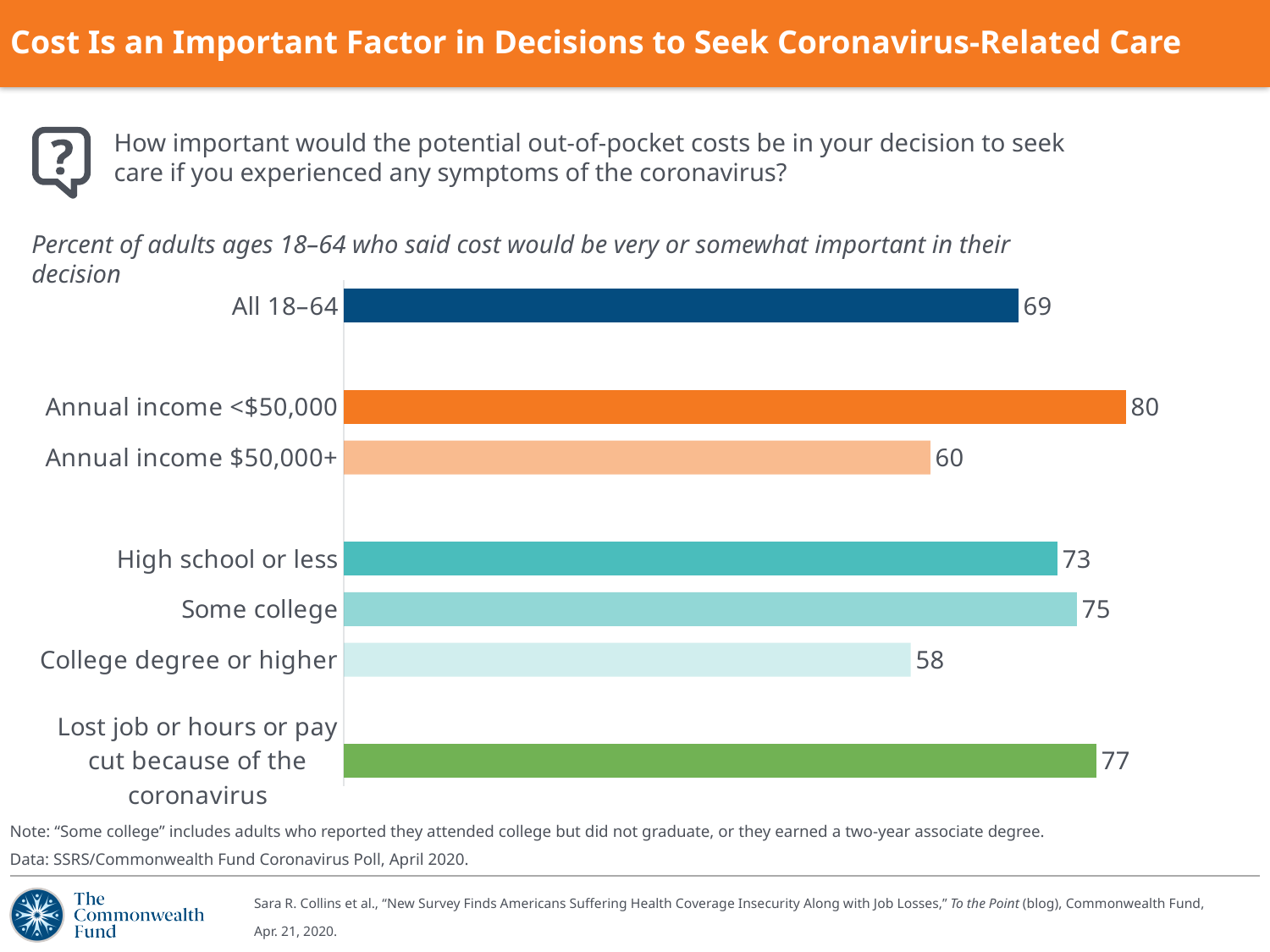
How many categories are shown in the chart? 7 What is the value for Annual income <$50,000? 80 Which category has the highest value? Annual income <$50,000 What is the difference between the values for Annual income <$50,000 and Annual income $50,000+? 20 What is the value for College degree or higher? 58 What is the value for Lost job or hours or pay cut because of the coronavirus? 77 What is the value for All 18–64? 69 What kind of chart is shown on the slide? Bar chart Which is larger, the value for High school or less or the value for College degree or higher? High school or less What colour is the bar for Lost job or hours or pay cut because of the coronavirus? Green What is the difference between the values for Some college and High school or less? 2 Which category has the lowest value? College degree or higher